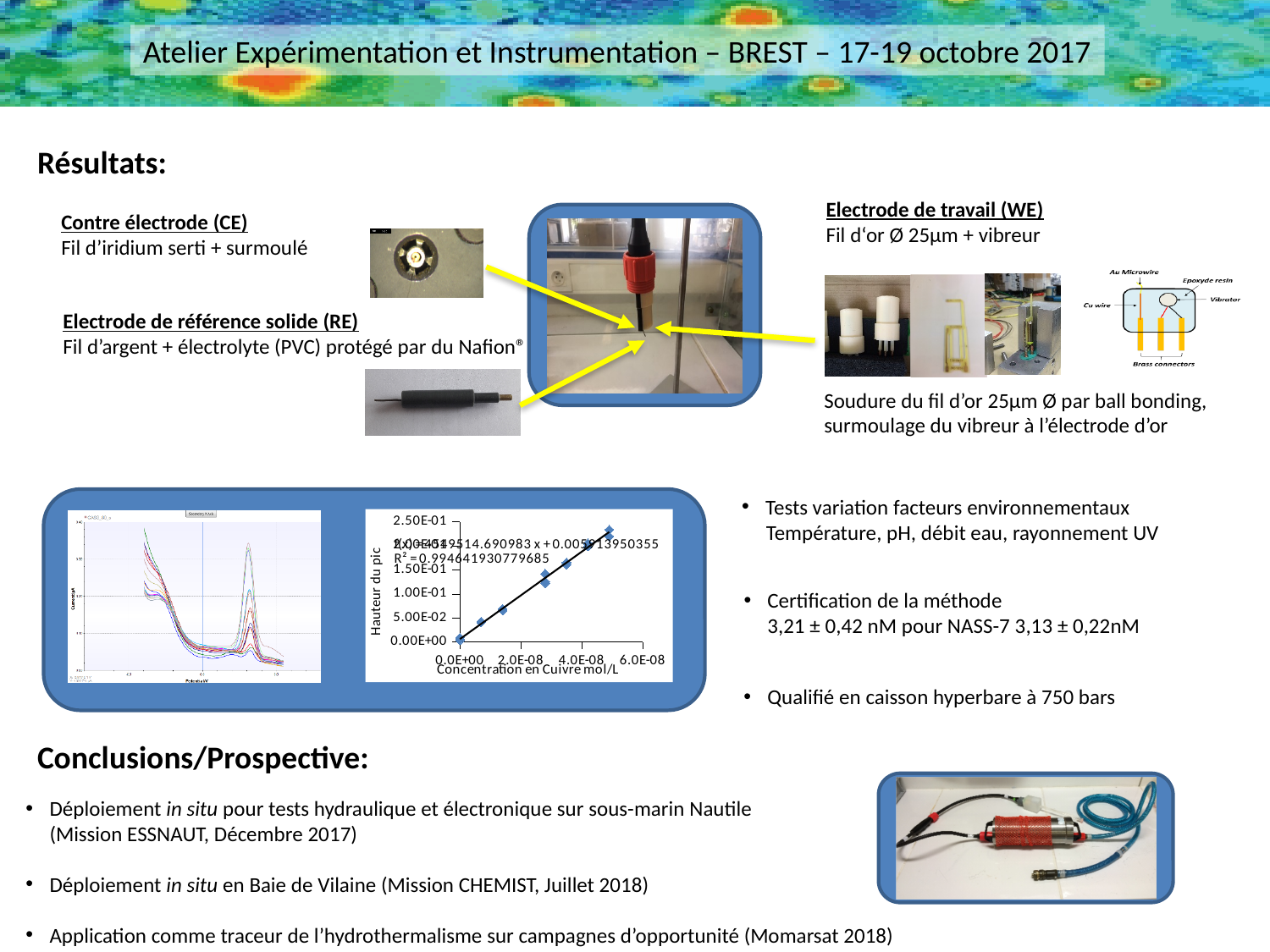
In the 'Hauteur du pic' chart, is the peak height at the highest concentration larger or smaller than the peak height at 0.0E+00 mol/L? larger In the 'Hauteur du pic' chart, is the peak height of the point at the highest copper concentration greater or less than 2.00E-01? greater In the 'Hauteur du pic' chart, is the peak height of the point at about 2.0E-08 mol/L greater or less than 5.00E-02? greater What kind of chart is shown in the box at the lower left of the slide (the one with axis title 'Hauteur du pic')? scatter chart with a trendline In the 'Hauteur du pic' chart, what R² value is printed for the fitted line? R² = 0.994641930779685 In the 'Hauteur du pic' chart, what is the title of the y axis? Hauteur du pic In the 'Hauteur du pic' chart, what is the highest tick value shown on the x axis? 6.0E-08 In the 'Hauteur du pic' chart, what is the title of the x axis? Concentration en Cuivre mol/L In the 'Hauteur du pic' chart, what is the highest tick value shown on the y axis? 2.50E-01 In the 'Hauteur du pic' chart, which point has the highest peak height: the one at the lowest concentration or the one at the highest concentration? the one at the highest concentration In the 'Hauteur du pic' chart, does the peak height rise or fall as the copper concentration increases? rise